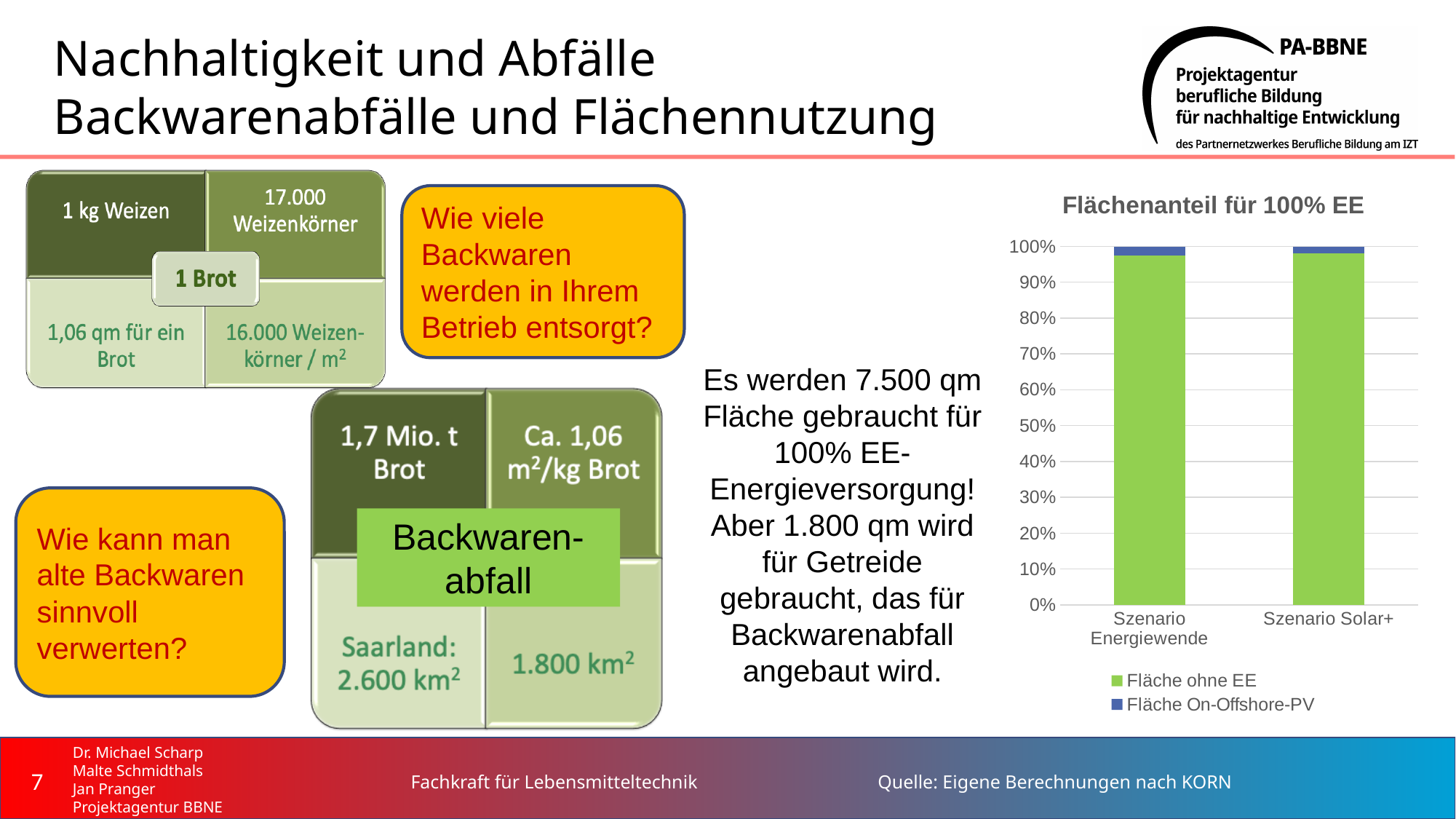
Is the value of Fläche ohne EE for Szenario Solar+ greater or less than 90%? greater What is the total height of the stacked bar for Szenario Energiewende? 100% What is the highest value shown on the y axis of the chart? 100% Which series is shown in green in the chart? Fläche ohne EE How many categories are shown on the x axis of the chart? 2 Is the value of Fläche On-Offshore-PV for Szenario Solar+ greater or less than 10%? less Within the Szenario Solar+ bar, which series is larger: Fläche ohne EE or Fläche On-Offshore-PV? Fläche ohne EE How many series does the chart's legend list? 2 What is the title of the chart on the slide? Flächenanteil für 100% EE Is the value of Fläche ohne EE for Szenario Energiewende greater or less than 90%? greater What kind of chart is shown on the slide? stacked bar chart